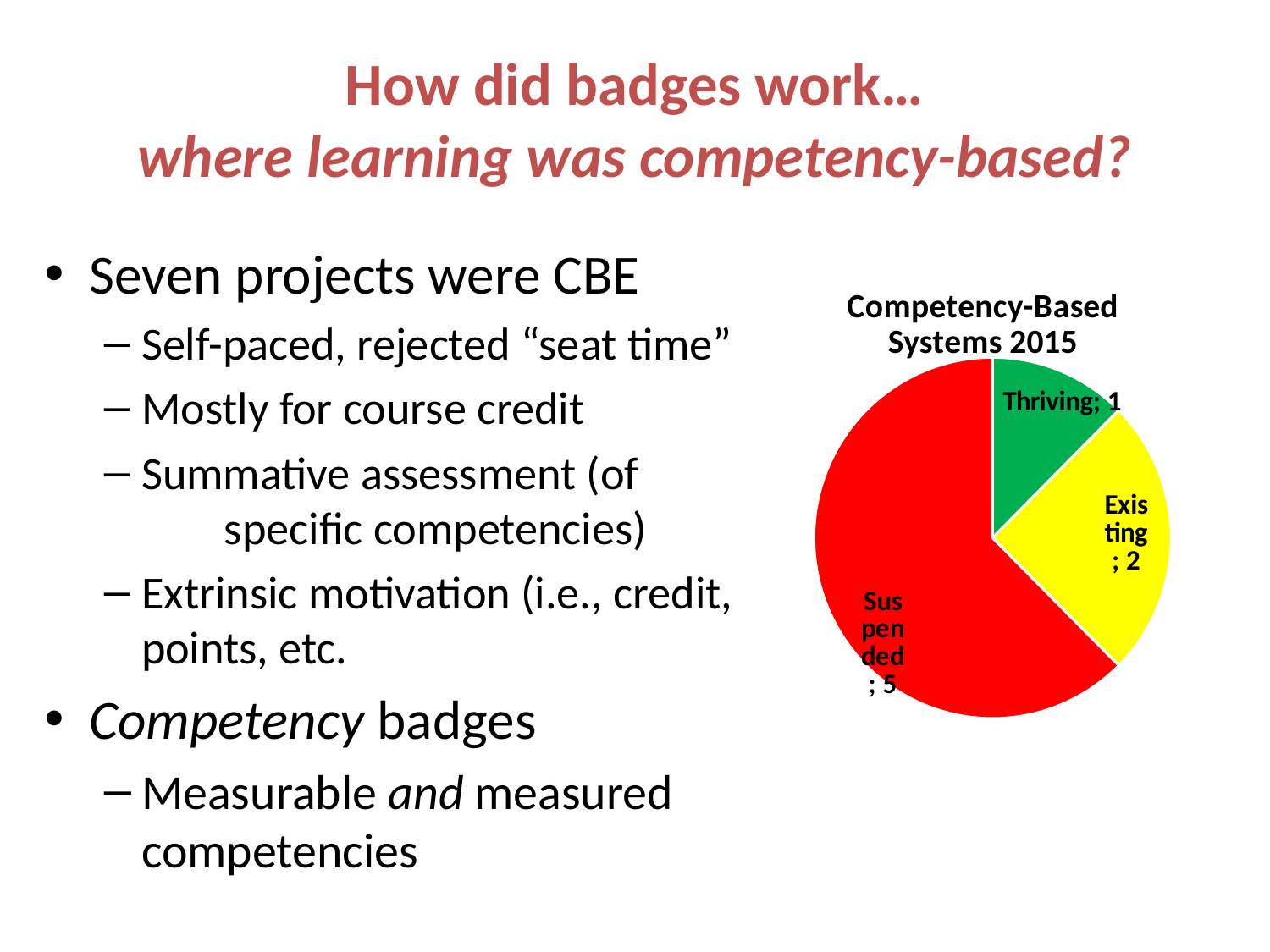
What is the difference between the values for Suspended and Existing? 3 Which category has the smallest slice? Thriving What type of chart is shown on the slide? pie chart What is the value for Thriving? 1 What is the value for Existing? 2 What is the value for Suspended? 5 Which category has the largest slice? Suspended What is the title of the chart? Competency-Based Systems 2015 What is the total of all slices in the pie chart? 8 How many slices does the pie chart have? 3 What colour is the Suspended slice? red Which is larger, Existing or Thriving? Existing